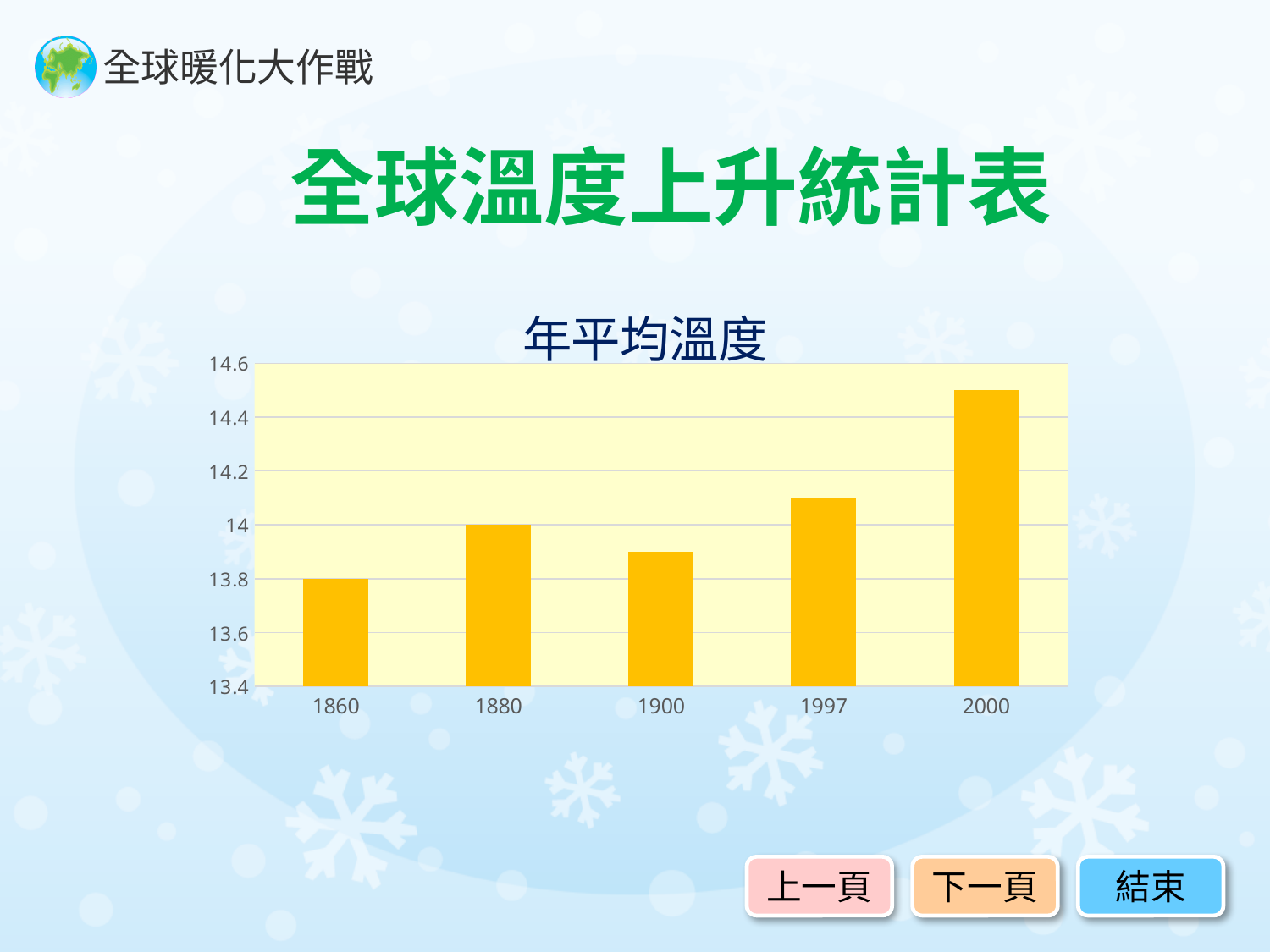
What is the value for 1860 in the 年平均溫度 chart? 13.8 What is the difference between the values for 1880 and 1860 in the 年平均溫度 chart? 0.2 Is the value for 2000 in the 年平均溫度 chart greater or less than 14.4? greater How many years are shown on the x axis of the 年平均溫度 chart? 5 What is the title of the chart on the slide? 年平均溫度 Which is larger in the 年平均溫度 chart, the value for 1900 or the value for 1997? 1997 What kind of chart is the 年平均溫度 chart? bar chart Is the value for 1900 in the 年平均溫度 chart greater or less than 14? less Is the value for 1997 in the 年平均溫度 chart greater or less than 14? greater What is the value for 1880 in the 年平均溫度 chart? 14 Which year has the lowest value in the 年平均溫度 chart? 1860 Which year has the highest value in the 年平均溫度 chart? 2000